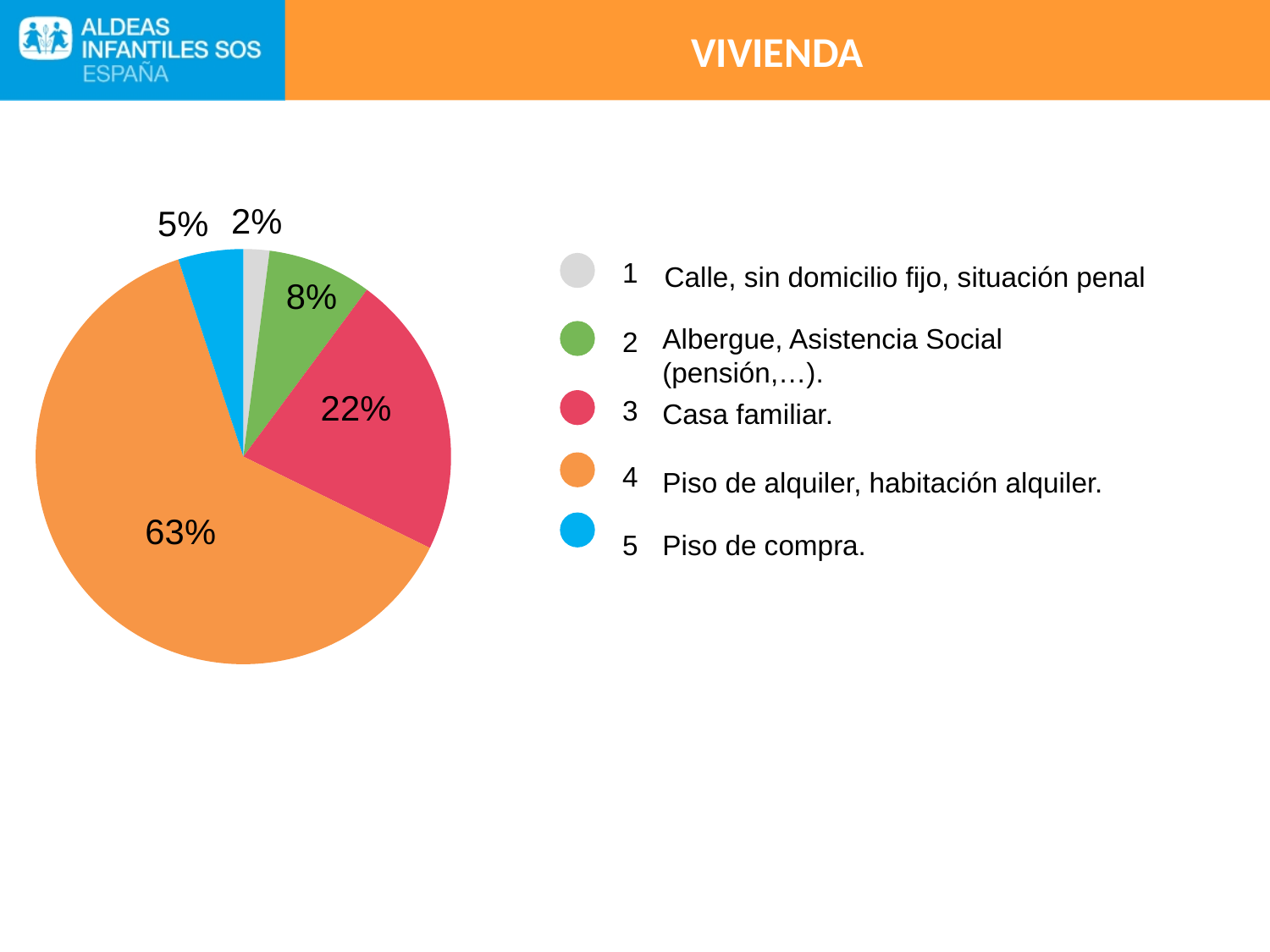
How many categories does the pie chart have? 5 What kind of chart is shown on the slide? Pie chart What percentage is shown for "Calle, sin domicilio fijo, situación penal"? 2% Which category has the smallest slice of the pie? Calle, sin domicilio fijo, situación penal What percentage is shown for "Piso de compra"? 5% What percentage is shown for "Albergue, Asistencia Social (pensión,…)"? 8% What share of the pie does "Piso de alquiler, habitación alquiler" represent? 63% What percentage is shown for "Casa familiar"? 22% What colour is the slice for "Casa familiar"? Red Which category has the largest slice of the pie? Piso de alquiler, habitación alquiler Which is larger, the share for "Albergue, Asistencia Social" or the share for "Piso de compra"? Albergue, Asistencia Social What is the difference in percentage points between "Piso de alquiler, habitación alquiler" and "Casa familiar"? 41